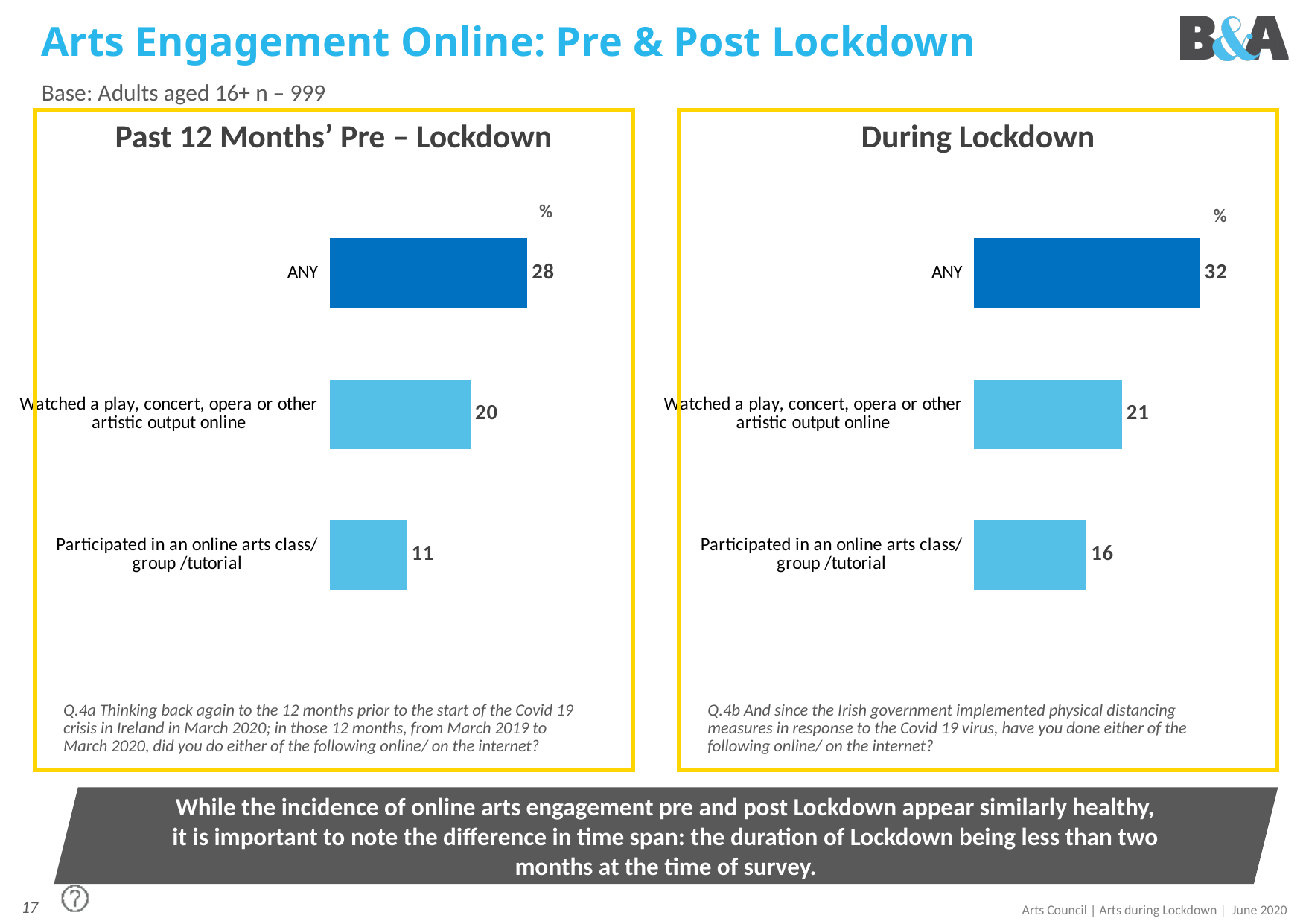
What type of chart is the 'Past 12 Months' Pre – Lockdown' chart? Bar chart What is the difference between the 'Participated in an online arts class/ group /tutorial' value in the 'During Lockdown' chart and the same category in the 'Past 12 Months' Pre – Lockdown' chart? 5 In the 'During Lockdown' chart, what is the value for 'Participated in an online arts class/ group /tutorial'? 16 In the 'During Lockdown' chart, which category has the highest value? ANY In the 'Past 12 Months' Pre – Lockdown' chart, what is the value for ANY? 28 In the 'Past 12 Months' Pre – Lockdown' chart, what is the difference between the values for ANY and 'Watched a play, concert, opera or other artistic output online'? 8 In the 'During Lockdown' chart, what is the value for 'Watched a play, concert, opera or other artistic output online'? 21 Which is larger: the ANY value in the 'During Lockdown' chart or the ANY value in the 'Past 12 Months' Pre – Lockdown' chart? During Lockdown In the 'Past 12 Months' Pre – Lockdown' chart, what unit is indicated above the bars? % How many categories are shown in the 'During Lockdown' chart? 3 What is the title of the chart on the right side of the slide? During Lockdown In the 'Past 12 Months' Pre – Lockdown' chart, which category has the lowest value? Participated in an online arts class/ group /tutorial